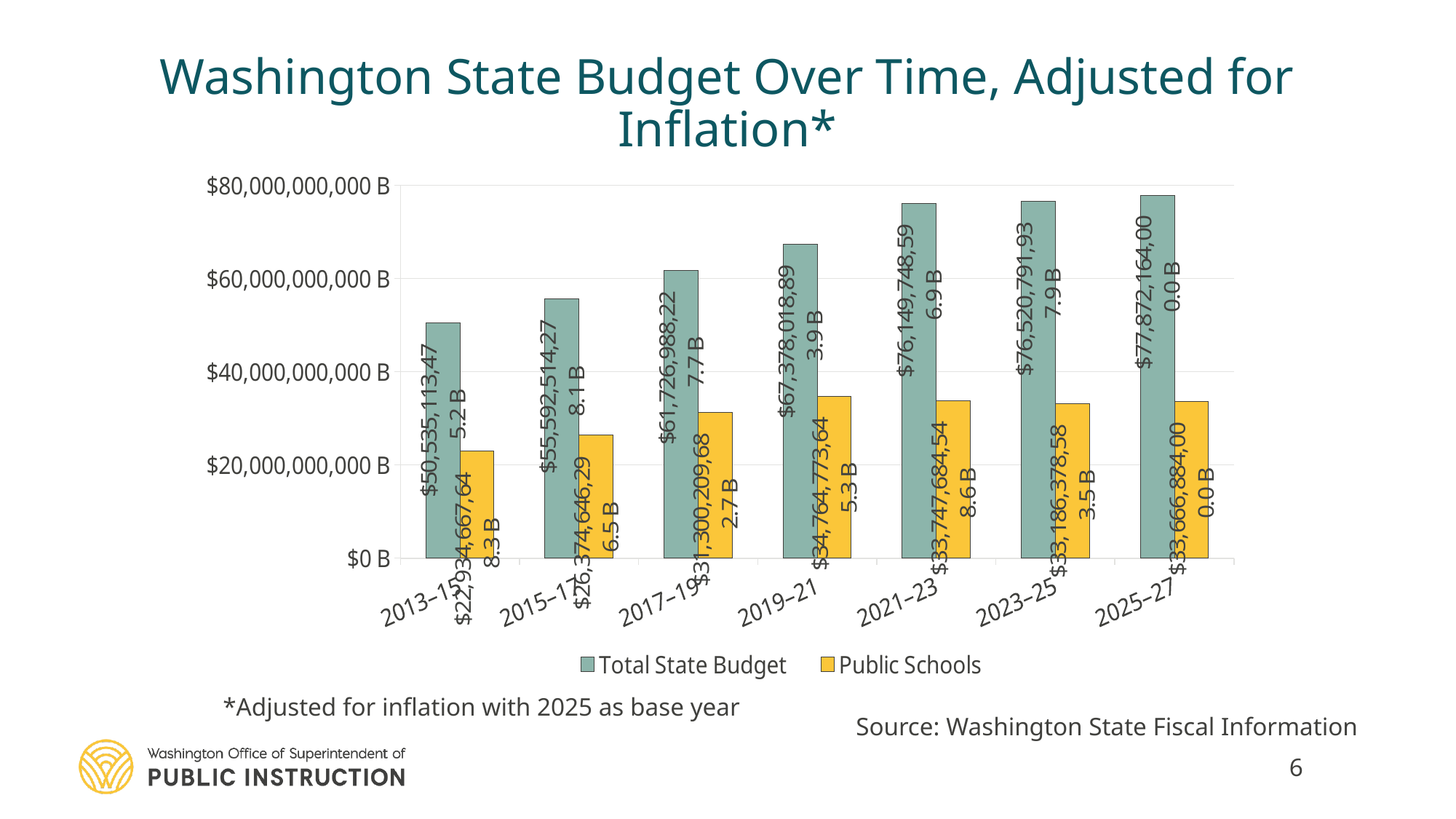
Is the Public Schools value for 2019–21 greater or less than $40,000,000,000 B? less Which period has the lowest Public Schools value? 2013–15 Which is larger in 2017–19, the Total State Budget or the Public Schools value? Total State Budget Which series is shown in yellow in the legend? Public Schools How many biennium periods are shown on the x axis? 7 What kind of chart is shown on the slide? bar chart How many series does the legend list? 2 Which period has the lowest Total State Budget? 2013–15 Which period has the highest Total State Budget? 2025–27 Is the Total State Budget for 2021–23 greater or less than $60,000,000,000 B? greater Is the Total State Budget for 2013–15 greater or less than $40,000,000,000 B? greater Does the Total State Budget rise or fall from 2013–15 to 2025–27? rise